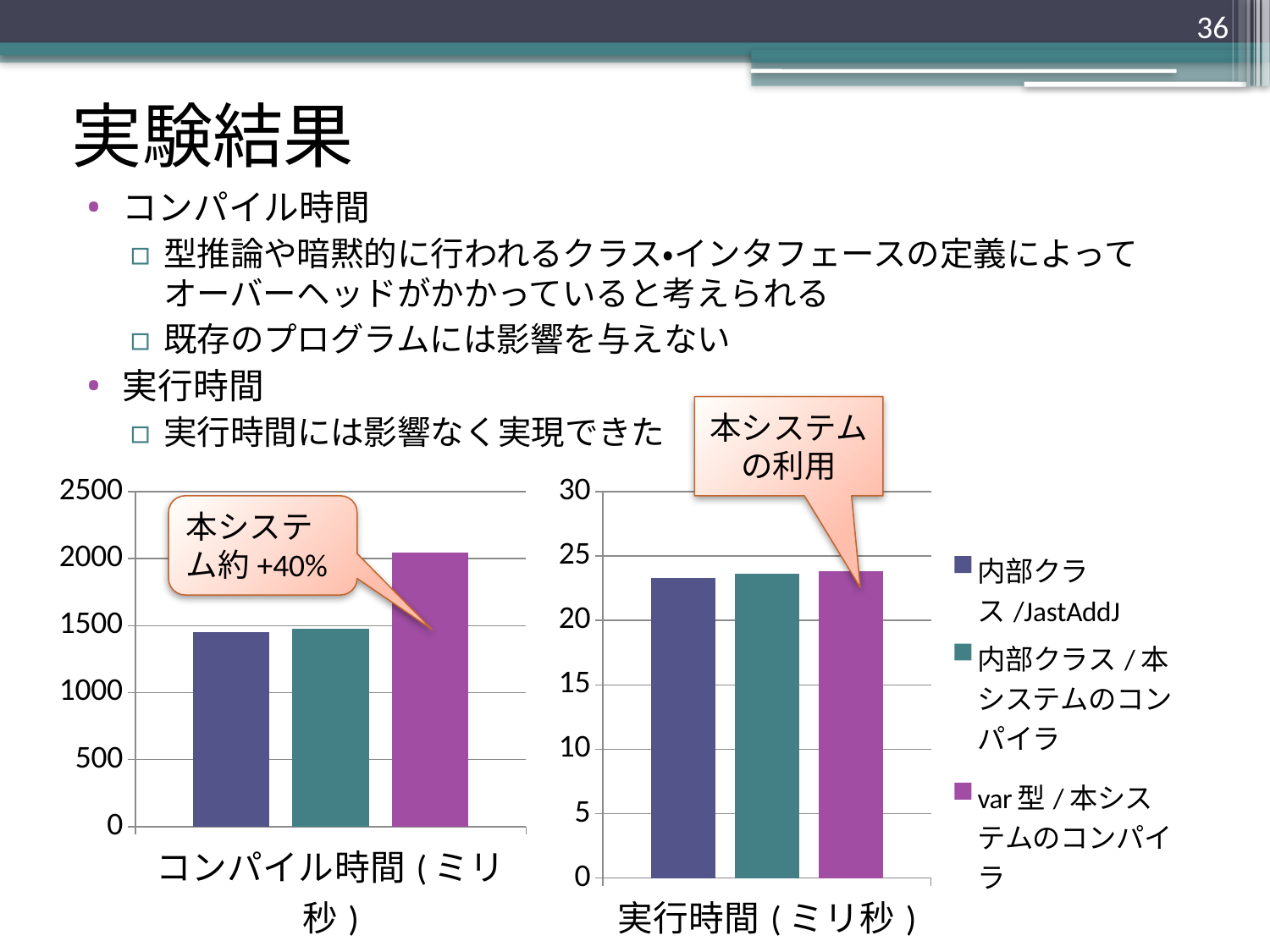
What kind of chart is the right chart titled 実行時間（ミリ秒）? bar chart In the right chart titled 実行時間（ミリ秒）, is the value for var型 / 本システムのコンパイラ greater or less than 25? less In the left chart titled コンパイル時間（ミリ秒）, which is larger: the value for var型 / 本システムのコンパイラ or the value for 内部クラス / JastAddJ? var型 / 本システムのコンパイラ What is the maximum value shown on the vertical axis of the left chart titled コンパイル時間（ミリ秒）? 2500 In the left chart titled コンパイル時間（ミリ秒）, is the value for var型 / 本システムのコンパイラ greater or less than 1500? greater In the left chart titled コンパイル時間（ミリ秒）, which series has the highest value? var型 / 本システムのコンパイラ What does the callout on the left chart titled コンパイル時間（ミリ秒） say? 本システム約+40% What kind of chart is the left chart titled コンパイル時間（ミリ秒）? bar chart In the left chart titled コンパイル時間（ミリ秒）, is the value for 内部クラス / JastAddJ greater or less than 1000? greater How many series does the legend list for the charts on the slide? 3 How many bars are plotted in the right chart titled 実行時間（ミリ秒）? 3